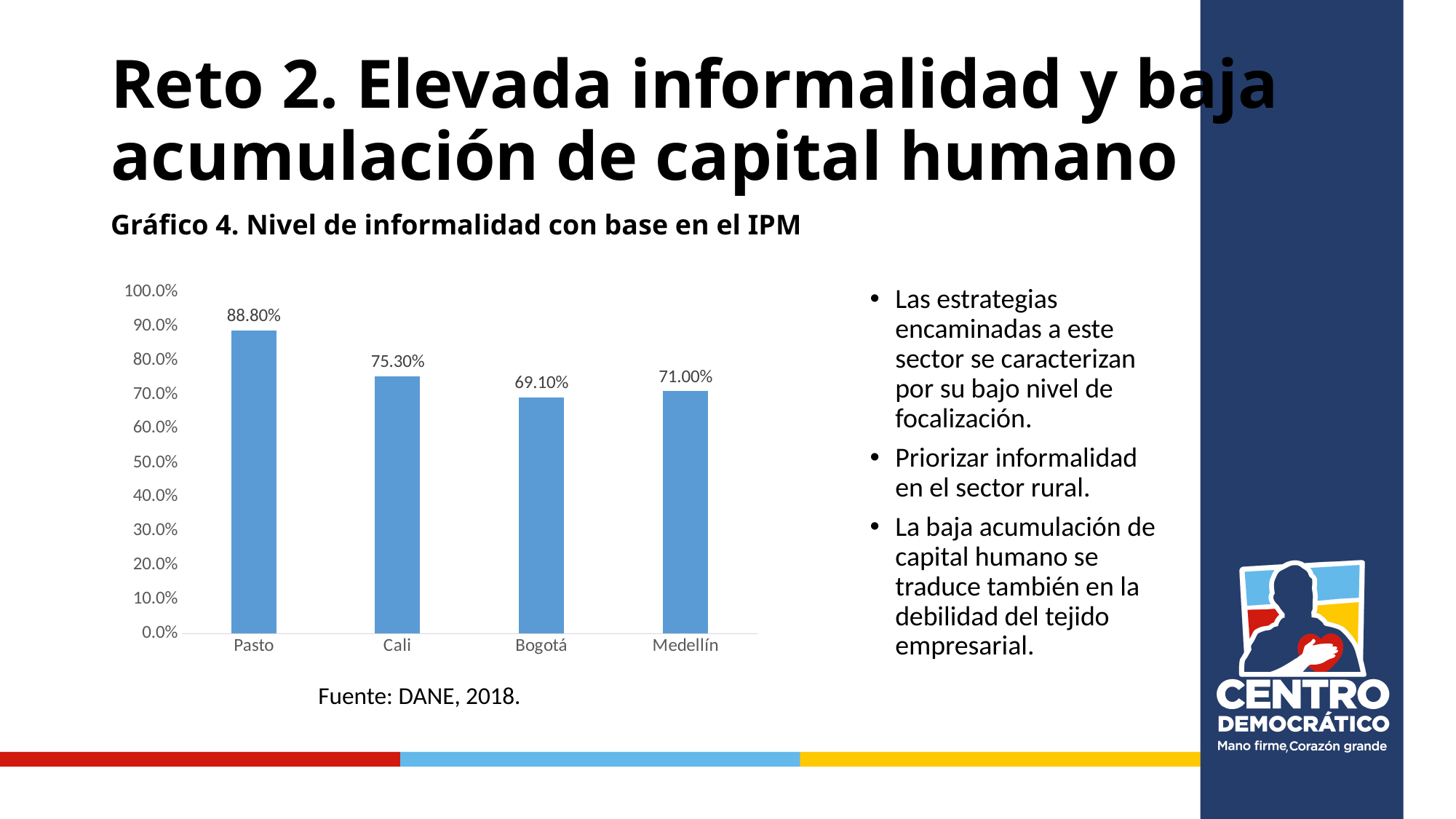
How many cities are shown in the chart? 4 Which city has the highest level of informality? Pasto What is the title of the chart? Gráfico 4. Nivel de informalidad con base en el IPM What is the value for Pasto? 88.80% Is the value for Cali greater or less than 80.0%? less What is the difference between the values for Pasto and Cali? 13.50% Which is larger, the value for Medellín or the value for Bogotá? Medellín What is the value for Cali? 75.30% What is the value for Medellín? 71.00% What kind of chart is shown on the slide? bar chart What is the value for Bogotá? 69.10% Which city has the lowest level of informality? Bogotá